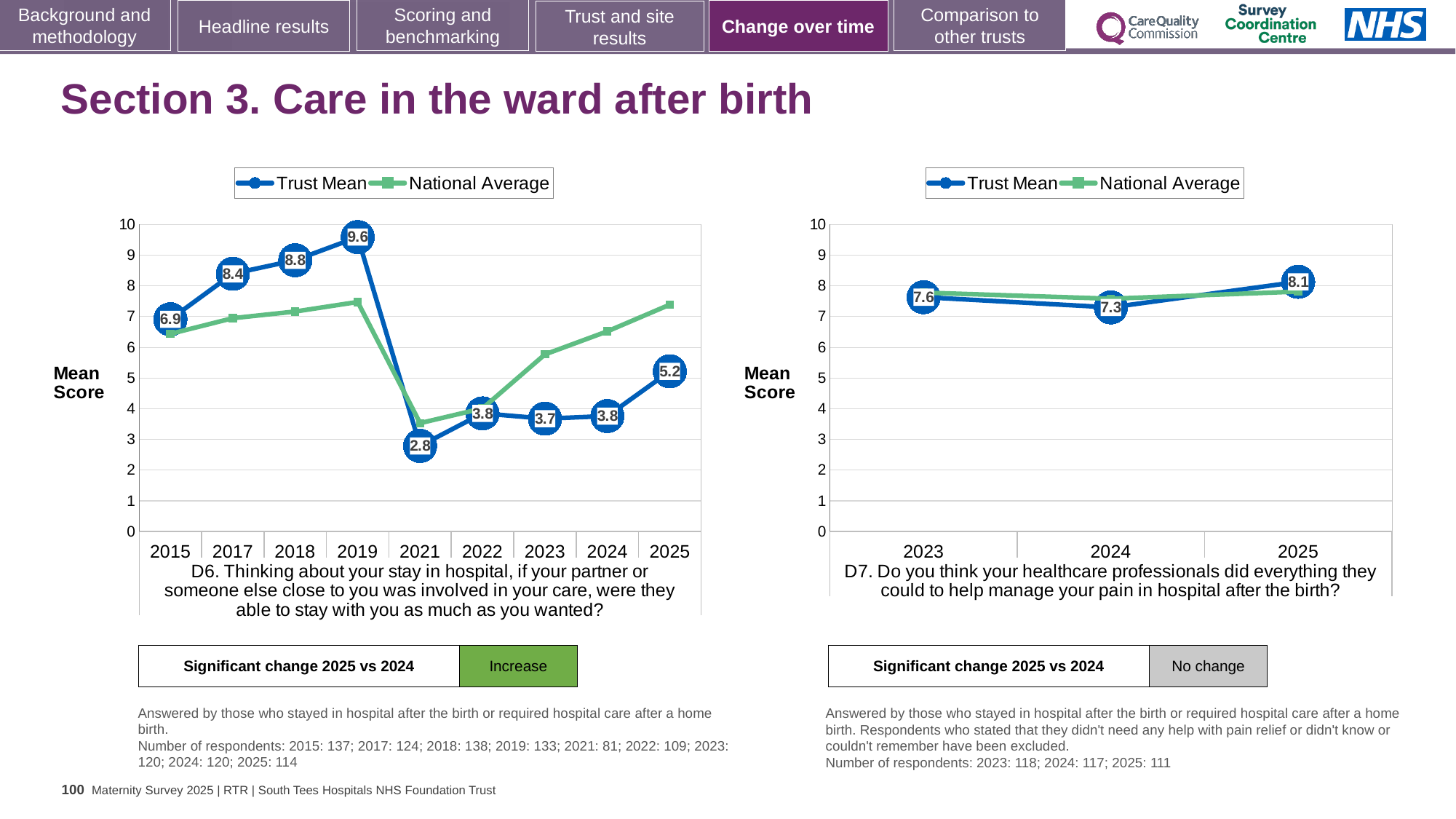
In the left chart (D6), is the National Average for 2025 greater or less than 7? greater In the left chart (D6), what is the Trust Mean score for 2019? 9.6 In the right chart (D7), how many series does the legend list? 2 In the left chart (D6), which year has the lowest Trust Mean score? 2021 In the left chart (D6), how many years are shown on the x axis? 9 In the right chart (D7), what is the Trust Mean score for 2024? 7.3 In the left chart (D6), which year has the highest Trust Mean score? 2019 In the right chart (D7), which year has the highest Trust Mean score? 2025 What type of chart is the right chart (D7)? Line chart In the left chart (D6), what is the difference between the Trust Mean scores for 2025 and 2024? 1.4 In the right chart (D7), what is the difference between the Trust Mean scores for 2025 and 2023? 0.5 In the left chart (D6), what is the Trust Mean score for 2025? 5.2